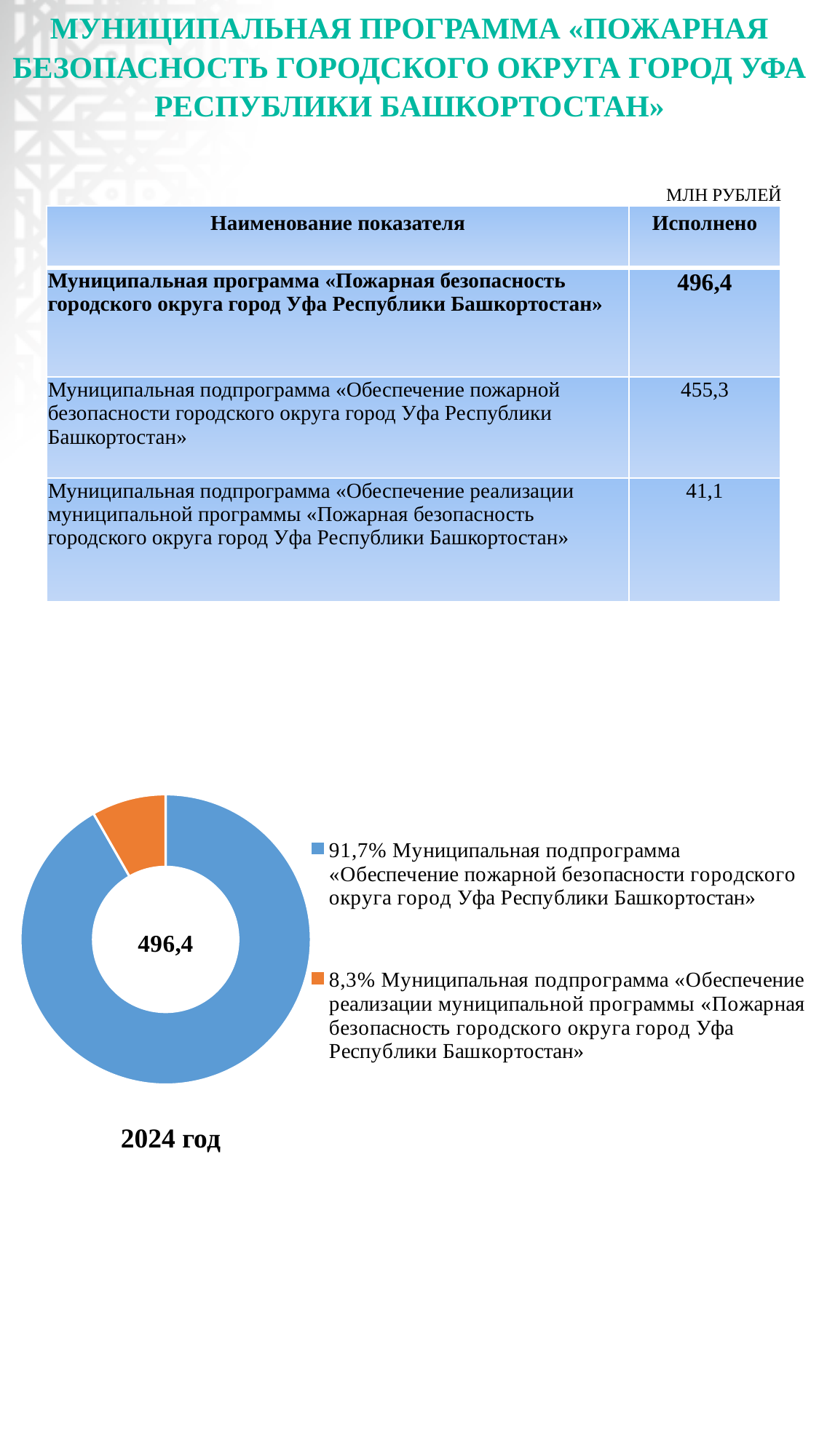
What kind of chart is shown on the slide? doughnut (pie) chart What colour is the slice for the subprogram «Обеспечение реализации муниципальной программы «Пожарная безопасность...»? orange Which slice of the doughnut chart is the smallest? Муниципальная подпрограмма «Обеспечение реализации муниципальной программы «Пожарная безопасность городского округа город Уфа Республики Башкортостан» What share of the doughnut chart is taken by the subprogram «Обеспечение пожарной безопасности городского округа город Уфа Республики Башкортостан»? 91,7% How many slices does the doughnut chart have? 2 Which year is labelled under the doughnut chart? 2024 год Which slice of the doughnut chart is the largest? Муниципальная подпрограмма «Обеспечение пожарной безопасности городского округа город Уфа Республики Башкортостан» By how many percentage points does the share of the 91,7% slice exceed the share of the 8,3% slice? 83,4 What share of the doughnut chart is taken by the subprogram «Обеспечение реализации муниципальной программы «Пожарная безопасность городского округа город Уфа Республики Башкортостан»? 8,3% How many entries does the legend of the doughnut chart list? 2 What value is printed in the centre of the doughnut chart? 496,4 Which is larger in the doughnut chart: the share of the subprogram «Обеспечение пожарной безопасности...» or the share of the subprogram «Обеспечение реализации муниципальной программы...»? Муниципальная подпрограмма «Обеспечение пожарной безопасности городского округа город Уфа Республики Башкортостан»